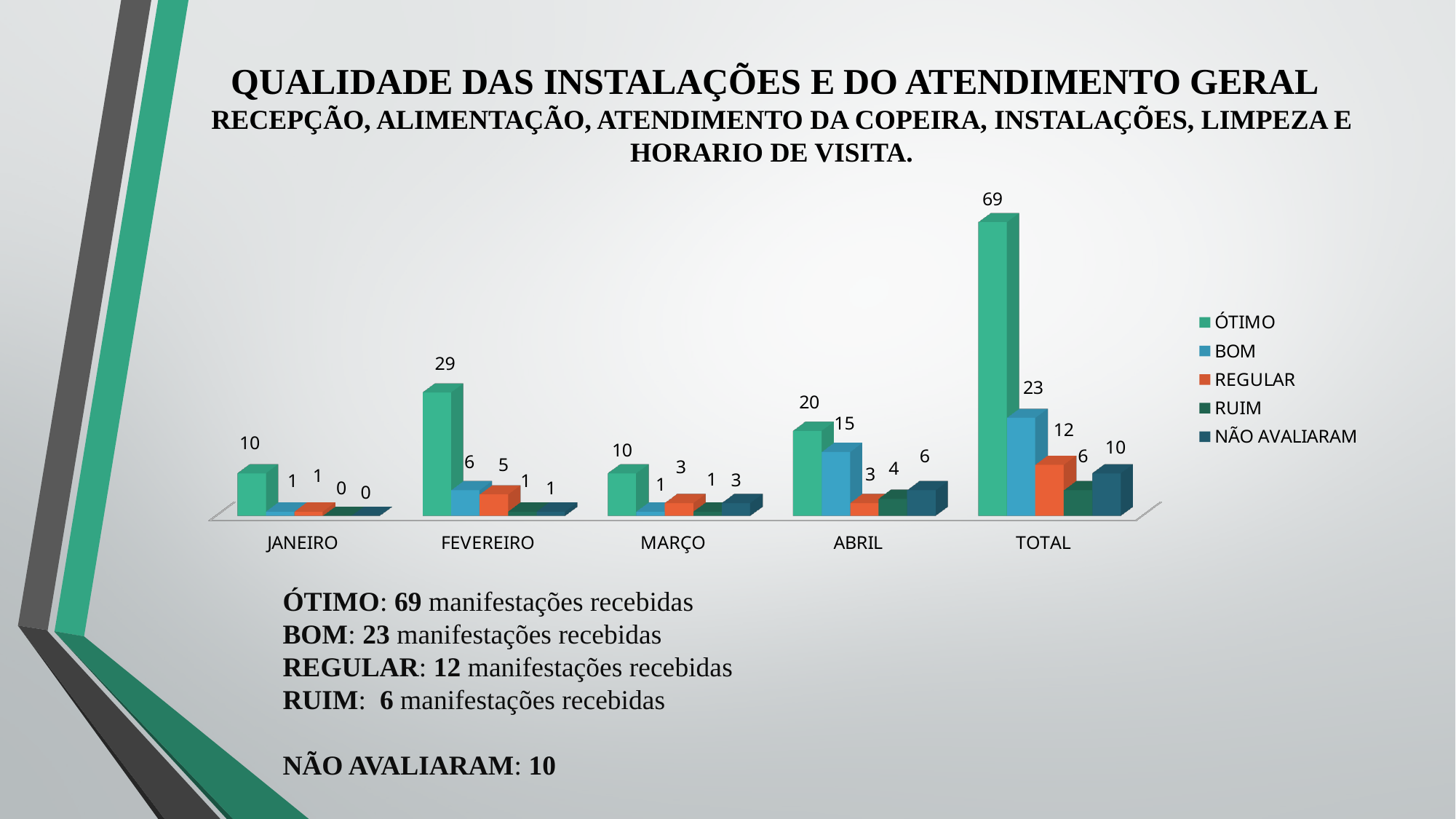
What is the value for REGULAR in the TOTAL category? 12 What kind of chart is shown on the slide? Bar chart What is the difference between the ÓTIMO and BOM values in the TOTAL category? 46 What is the value for BOM in ABRIL? 15 How many categories are shown on the x axis? 5 Which category has the lowest value for RUIM? JANEIRO What is the value for ÓTIMO in FEVEREIRO? 29 How many series does the legend list? 5 Which month has the highest ÓTIMO value, excluding TOTAL? FEVEREIRO Which series is shown in orange in the legend? REGULAR Which is larger, the BOM value in FEVEREIRO or the BOM value in ABRIL? ABRIL What is the value for NÃO AVALIARAM in MARÇO? 3